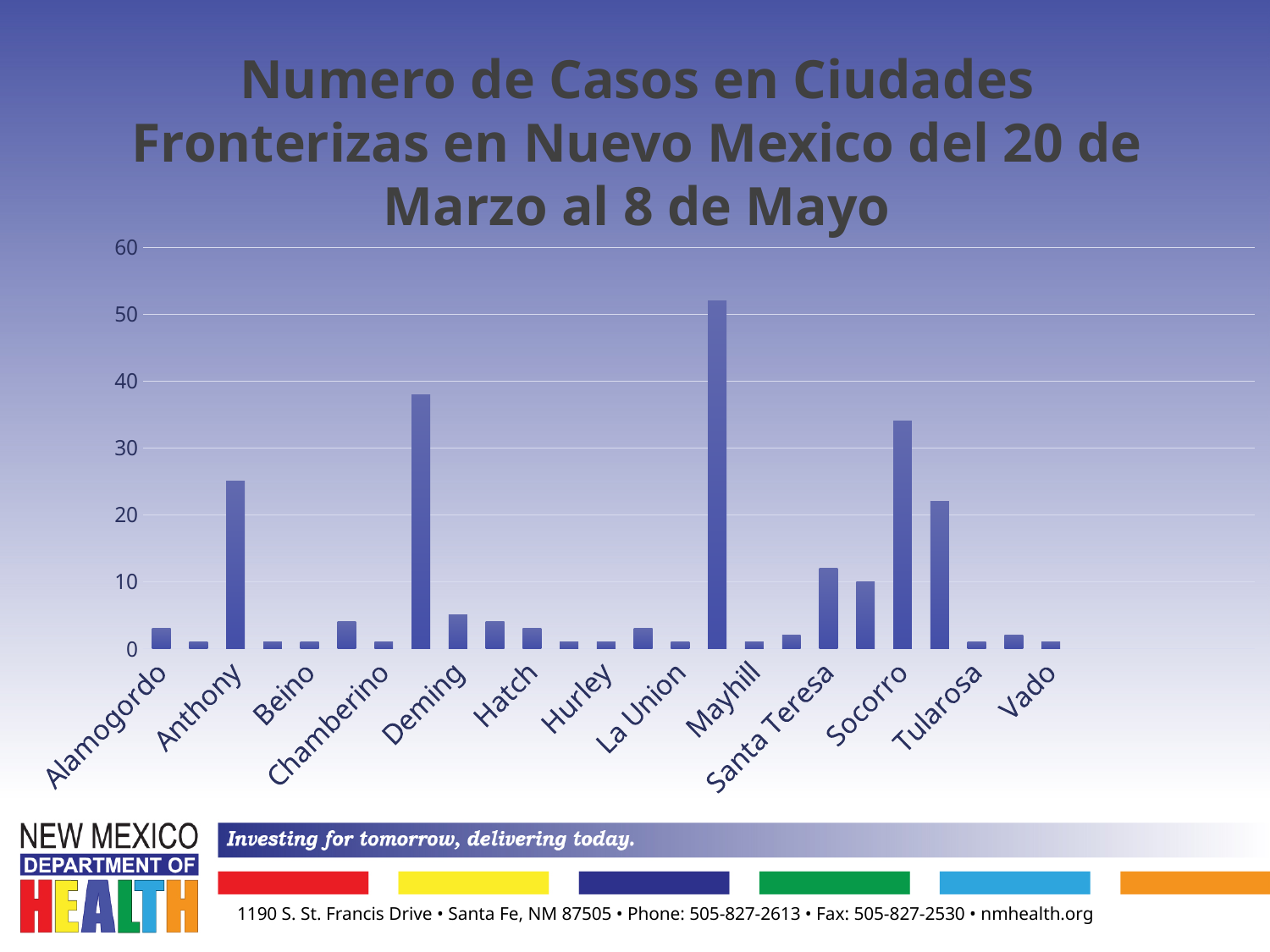
Is the value for Anthony greater or less than 20? greater Is the value for Socorro greater or less than 30? greater What is the title of the chart? Numero de Casos en Ciudades Fronterizas en Nuevo Mexico del 20 de Marzo al 8 de Mayo Which has a larger value, Socorro or Hatch? Socorro Which has a larger value, Socorro or Anthony? Socorro Is the value for Santa Teresa greater or less than 20? less How many city names are labeled on the horizontal axis? 13 What kind of chart is shown on the slide? bar chart Which has a larger value, Anthony or Santa Teresa? Anthony What is the highest value shown on the vertical axis? 60